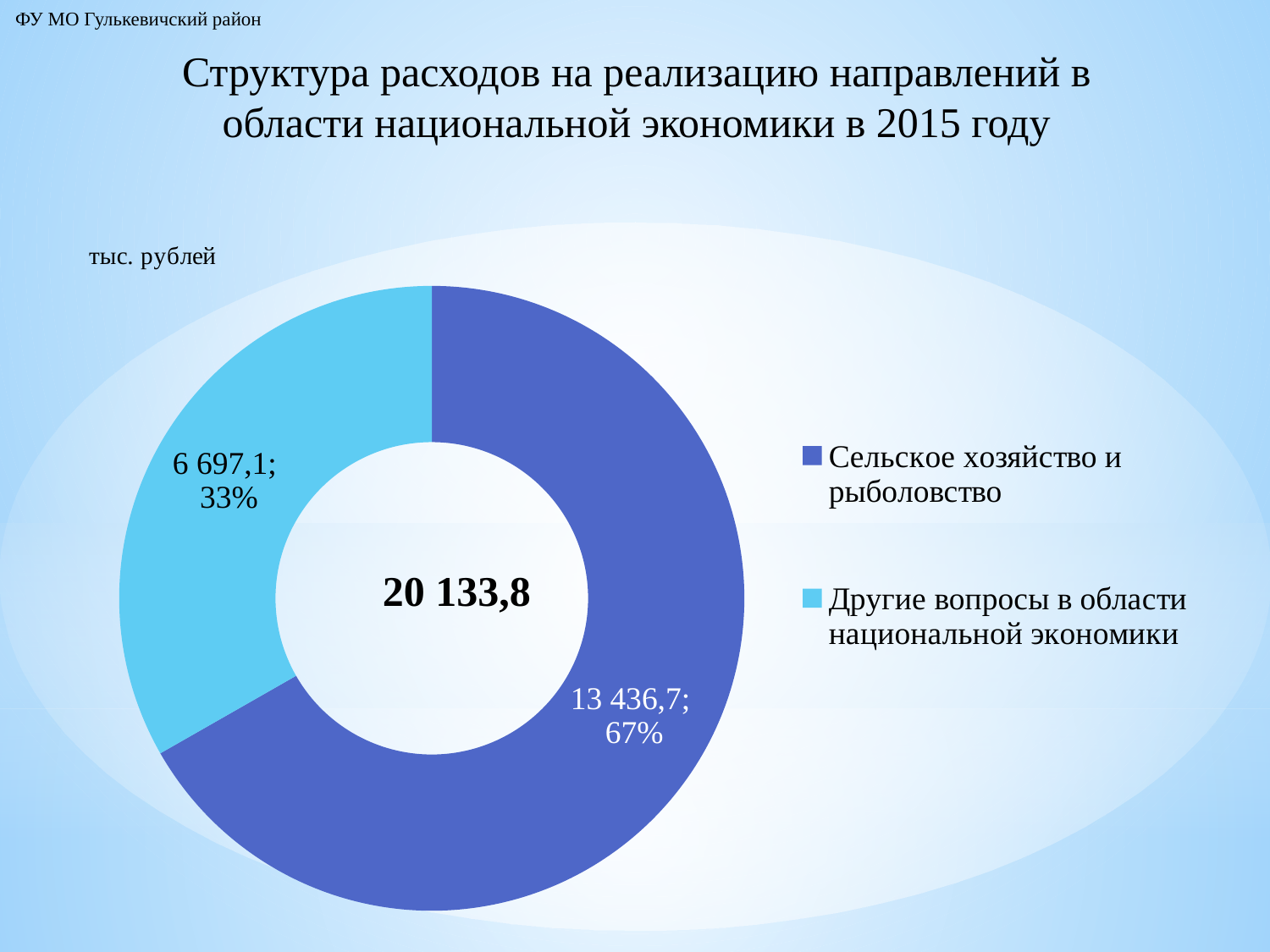
Which category has the smallest value? Другие вопросы в области национальной экономики What unit is indicated for the chart values? тыс. рублей What share of the chart does Сельское хозяйство и рыболовство take? 67% What kind of chart is shown on the slide? Doughnut (pie) chart Which is larger: Сельское хозяйство и рыболовство or Другие вопросы в области национальной экономики? Сельское хозяйство и рыболовство What is the difference between the values for Сельское хозяйство и рыболовство and Другие вопросы в области национальной экономики? 6 739,6 What total value is shown in the centre of the chart? 20 133,8 Which category has the largest value? Сельское хозяйство и рыболовство How many categories does the chart show? 2 What share of the chart does Другие вопросы в области национальной экономики take? 33% What is the value for Другие вопросы в области национальной экономики? 6 697,1 What is the value for Сельское хозяйство и рыболовство? 13 436,7